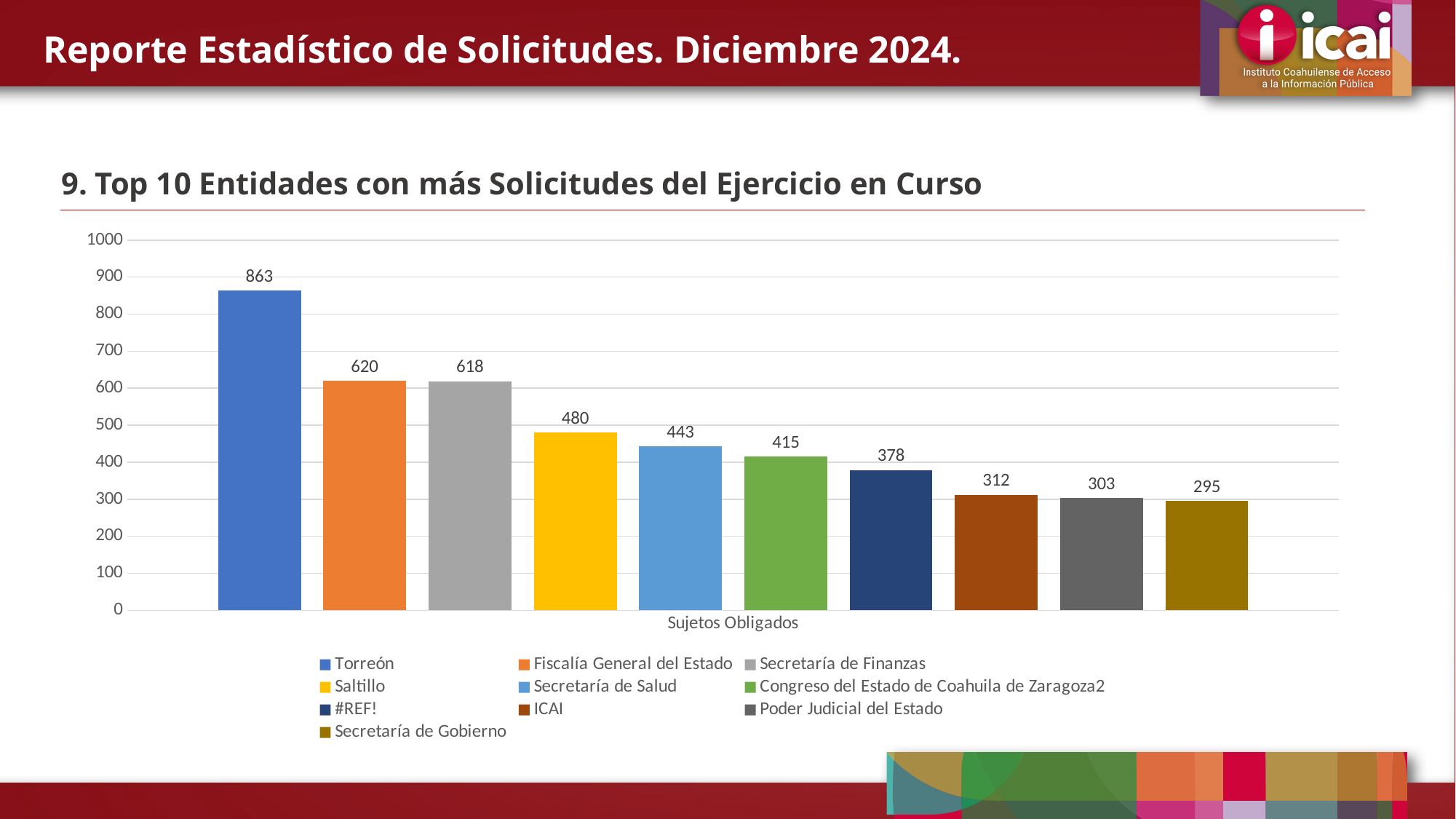
What is the value for Poder Judicial del Estado? 303 What is the value for Torreón? 863 Which is larger, the value for Secretaría de Salud or the value for Congreso del Estado de Coahuila de Zaragoza2? Secretaría de Salud What is the value for Secretaría de Salud? 443 What kind of chart is shown on the slide? Bar chart What is the value for Saltillo? 480 How many bars are shown in the chart? 10 Which entity has the highest value? Torreón What is the difference between the values for Torreón and Fiscalía General del Estado? 243 What is the difference between the values for Saltillo and ICAI? 168 Which entity has the lowest value? Secretaría de Gobierno How many entries does the legend list? 10